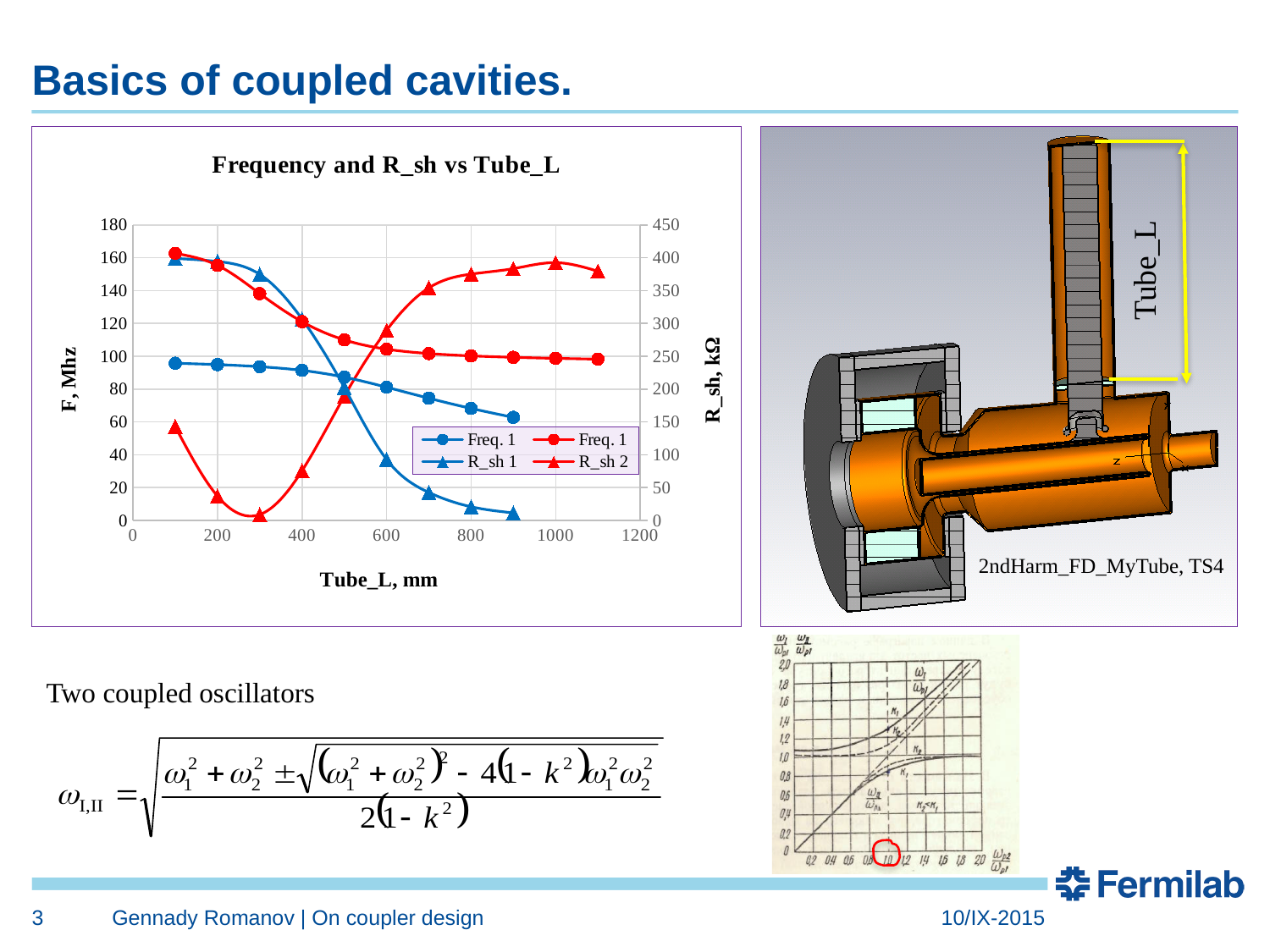
On the right axis (R_sh, kΩ), is the value of the red-triangle "R_sh 2" series at Tube_L = 300 mm greater or less than 50? less What kind of chart is "Frequency and R_sh vs Tube_L"? line chart Does the blue-triangle "R_sh 1" series rise or fall as Tube_L increases from 100 to 900 mm? fall How many series does the legend of the chart list? 4 Does the blue-circle "Freq. 1" series rise or fall as Tube_L increases? fall What is the maximum value shown on the right-hand y-axis (R_sh, kΩ) of the chart? 450 What is the title of the chart on the slide? Frequency and R_sh vs Tube_L How many data points are plotted for the blue-circle "Freq. 1" series? 9 On the left axis (F, Mhz), is the value of the blue-circle "Freq. 1" series at Tube_L = 900 mm greater or less than 80? less What is the x-axis title of the chart? Tube_L, mm Does the red-triangle "R_sh 2" series rise or fall as Tube_L increases from 300 to 1000 mm? rise How many data points are plotted for the red-triangle "R_sh 2" series? 11